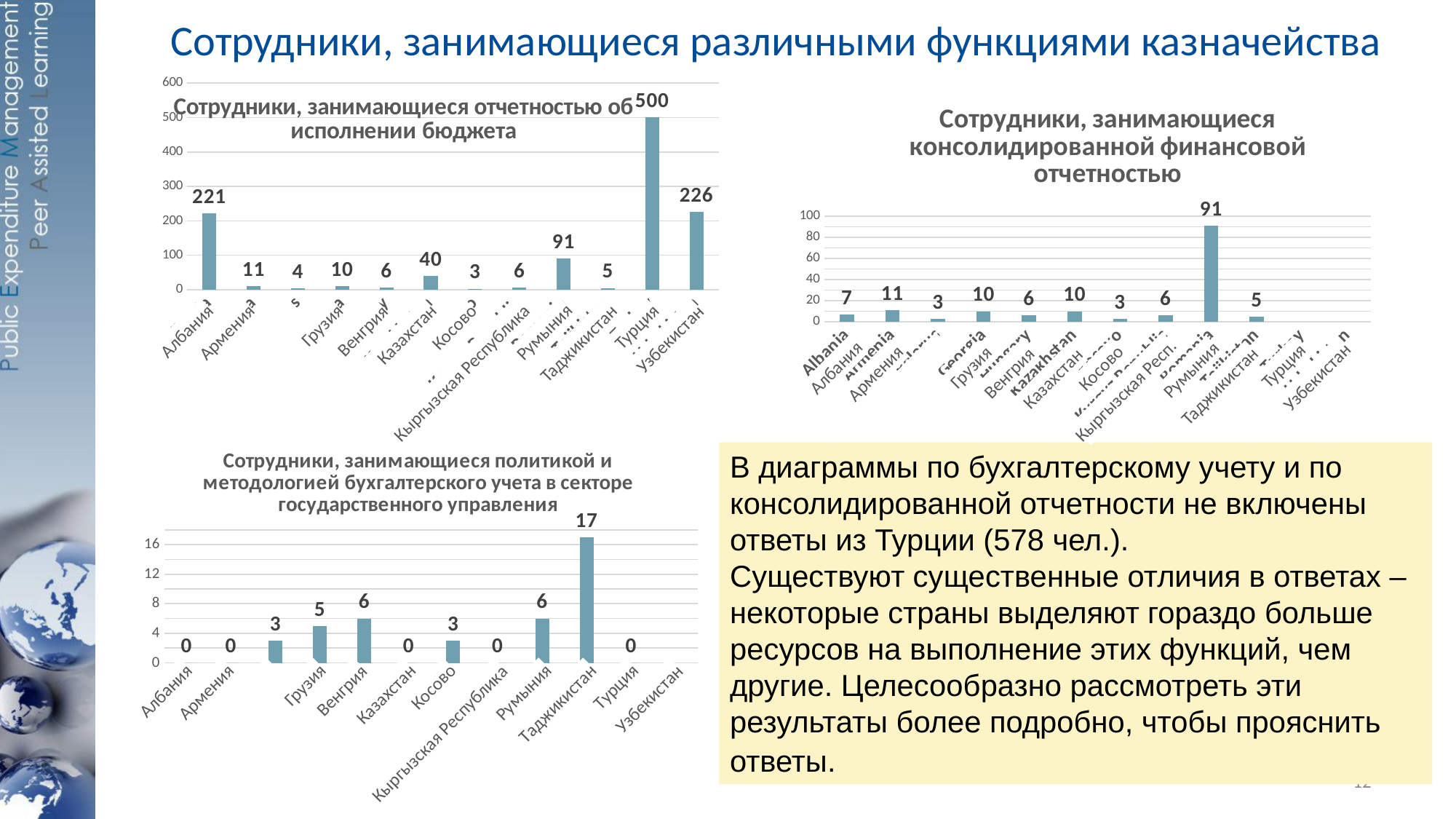
What kind of chart is the one titled «Сотрудники, занимающиеся политикой и методологией бухгалтерского учета в секторе государственного управления»? Bar chart On the chart titled «Сотрудники, занимающиеся политикой и методологией бухгалтерского учета в секторе государственного управления», what is the highest value shown? 17 On the chart titled «Сотрудники, занимающиеся консолидированной финансовой отчетностью», what is the difference between the values for Армения and Таджикистан? 6 On the chart titled «Сотрудники, занимающиеся отчетностью об исполнении бюджета», which is larger, the value for Румыния or the value for Казахстан? Румыния On the chart titled «Сотрудники, занимающиеся отчетностью об исполнении бюджета», what is the value for Турция? 500 On the chart titled «Сотрудники, занимающиеся консолидированной финансовой отчетностью», which category has the highest value? Румыния How many charts are shown on the slide? 3 On the chart titled «Сотрудники, занимающиеся отчетностью об исполнении бюджета», what is the difference between the values for Узбекистан and Албания? 5 On the chart titled «Сотрудники, занимающиеся консолидированной финансовой отчетностью», what is the value for Албания? 7 On the chart titled «Сотрудники, занимающиеся отчетностью об исполнении бюджета», which category has the highest value? Турция On the chart titled «Сотрудники, занимающиеся консолидированной финансовой отчетностью», what is the value for Румыния? 91 On the chart titled «Сотрудники, занимающиеся отчетностью об исполнении бюджета», what is the value for Казахстан? 40